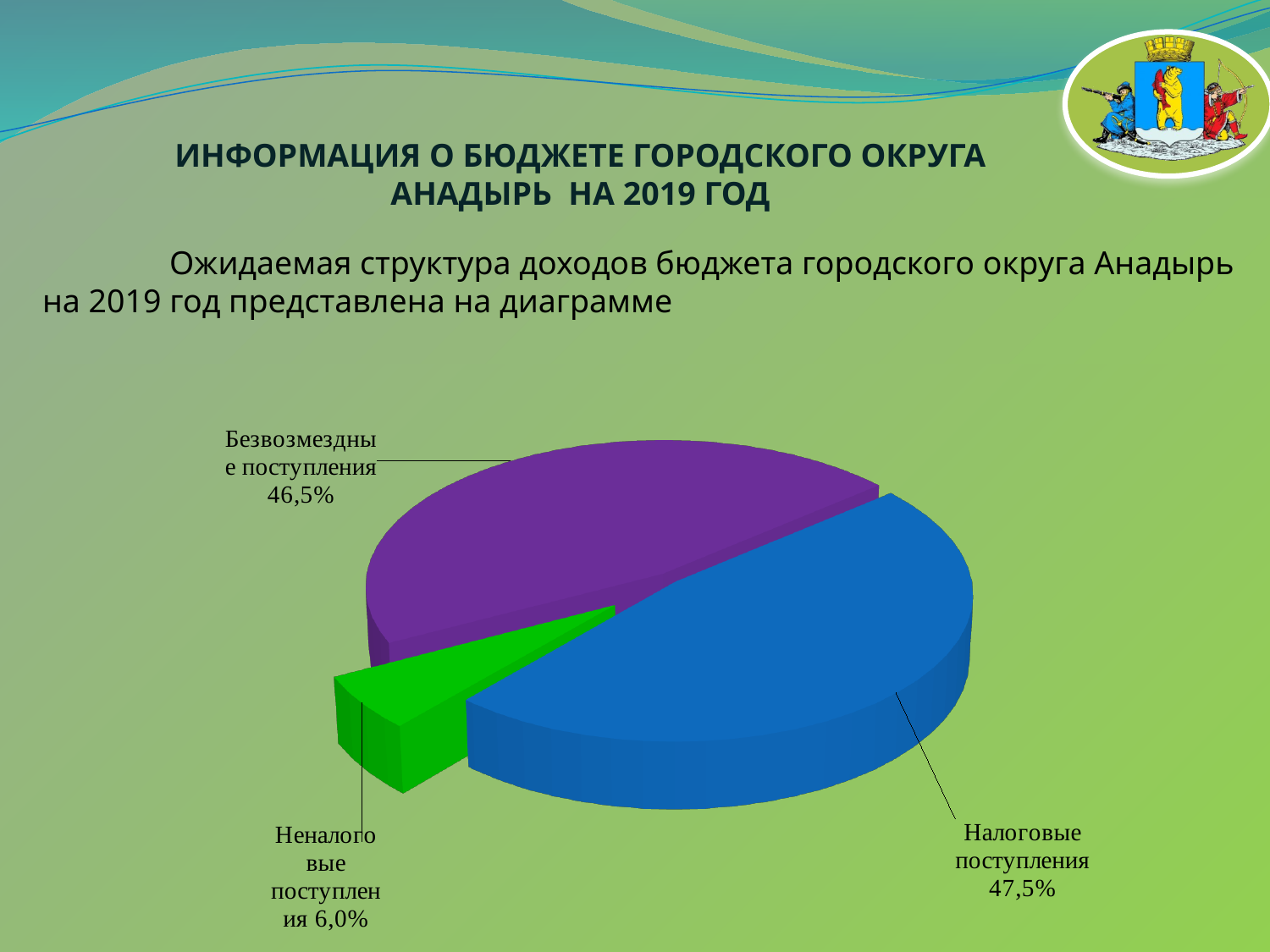
Which category has the smallest share of the pie? Неналоговые поступления What colour is the slice for Неналоговые поступления? Green Which category has the largest share of the pie? Налоговые поступления How many categories are shown in the pie chart? 3 What is the difference in percentage points between Налоговые поступления and Безвозмездные поступления? 1,0% What share of the pie is labelled for Неналоговые поступления? 6,0% What is the difference in percentage points between Безвозмездные поступления and Неналоговые поступления? 40,5% Which is larger: the share for Безвозмездные поступления or the share for Неналоговые поступления? Безвозмездные поступления What colour is the slice for Налоговые поступления? Blue What kind of chart is shown on the slide? Pie chart What share of the pie is labelled for Безвозмездные поступления? 46,5% What share of the pie is labelled for Налоговые поступления? 47,5%